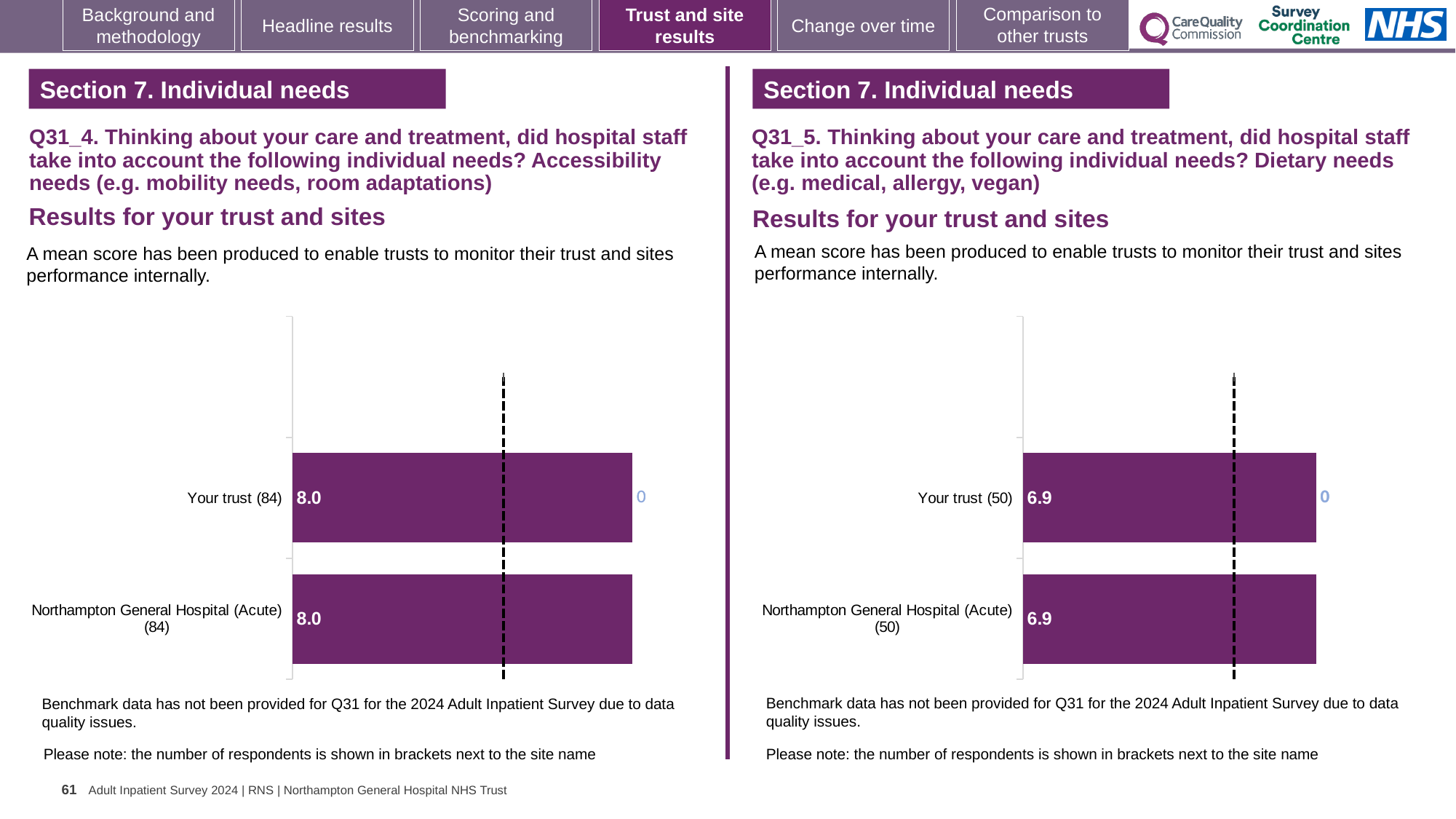
On the Q31_4 (Accessibility needs) chart, how many respondents are shown in brackets next to Your trust? 84 Is the Your trust score on the Q31_4 (Accessibility needs) chart larger or smaller than the Your trust score on the Q31_5 (Dietary needs) chart? Larger On the Q31_4 (Accessibility needs) chart, what is the mean score for Your trust? 8.0 On the Q31_5 (Dietary needs) chart, what is the difference between the score for Your trust and the score for Northampton General Hospital (Acute)? 0.0 On the Q31_4 (Accessibility needs) chart, what is the mean score for Northampton General Hospital (Acute)? 8.0 On the Q31_5 (Dietary needs) chart, what is the mean score for Your trust? 6.9 What type of chart is used on the Q31_5 (Dietary needs) chart? Bar chart On the Q31_4 (Accessibility needs) chart, what is the difference between the score for Your trust and the score for Northampton General Hospital (Acute)? 0.0 On the Q31_5 (Dietary needs) chart, how many respondents are shown in brackets next to Northampton General Hospital (Acute)? 50 How many bars are plotted on the Q31_4 (Accessibility needs) chart? 2 On the Q31_5 (Dietary needs) chart, what is the mean score for Northampton General Hospital (Acute)? 6.9 How many bars are plotted on the Q31_5 (Dietary needs) chart? 2